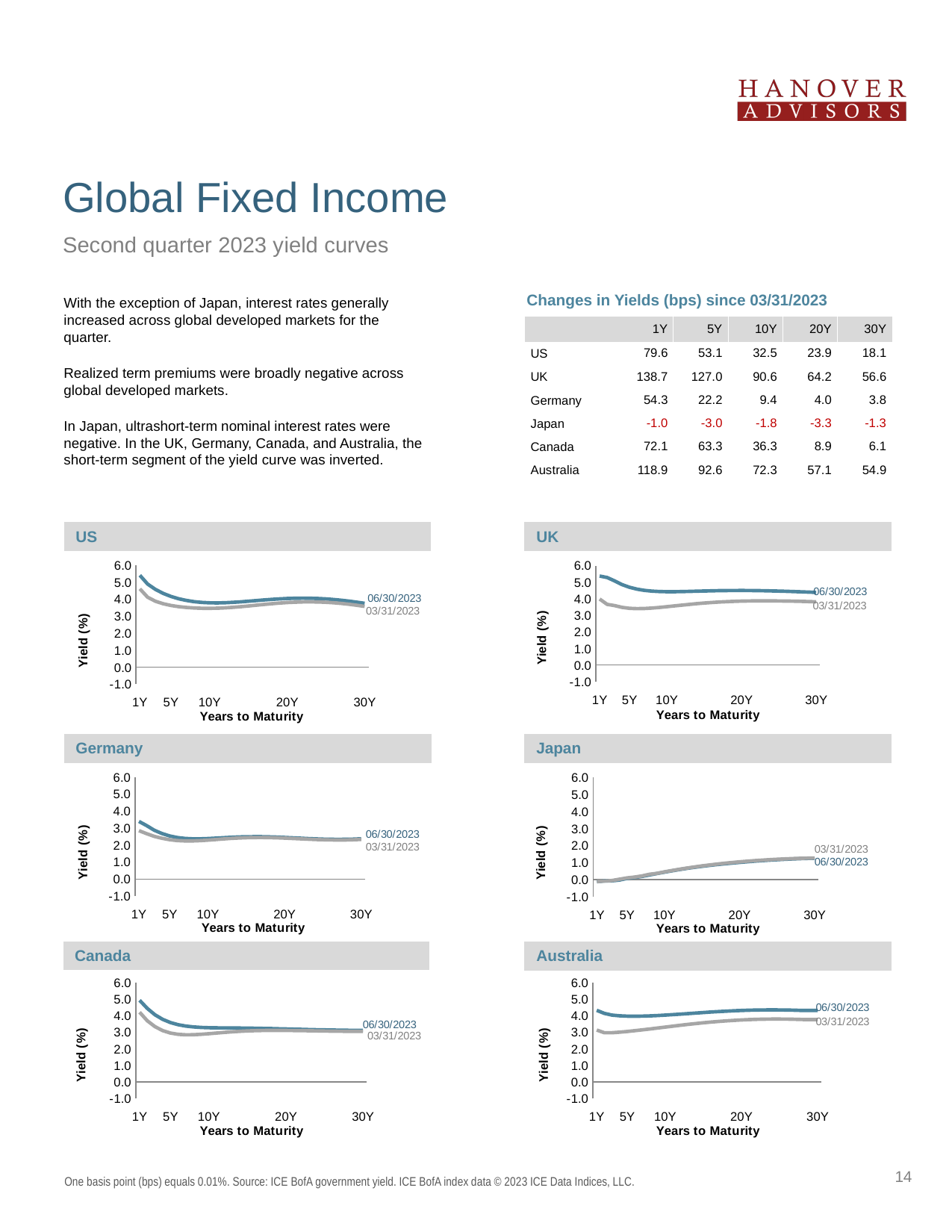
On the US chart, is the 06/30/2023 value at 1Y greater or less than 5.0? greater How many maturity labels are shown on the x axis of the Canada chart? 5 On the UK chart, is the 03/31/2023 value at 1Y greater or less than 5.0? less On the Australia chart, is the 03/31/2023 value at 1Y greater or less than 4.0? less How many series are plotted on the UK chart? 2 On the US chart, which series is higher at 1Y, 06/30/2023 or 03/31/2023? 06/30/2023 What kind of chart is the US chart? line chart What is the y-axis title on the Germany chart? Yield (%) On the Japan chart, does the 06/30/2023 line rise or fall from 1Y to 30Y? rise